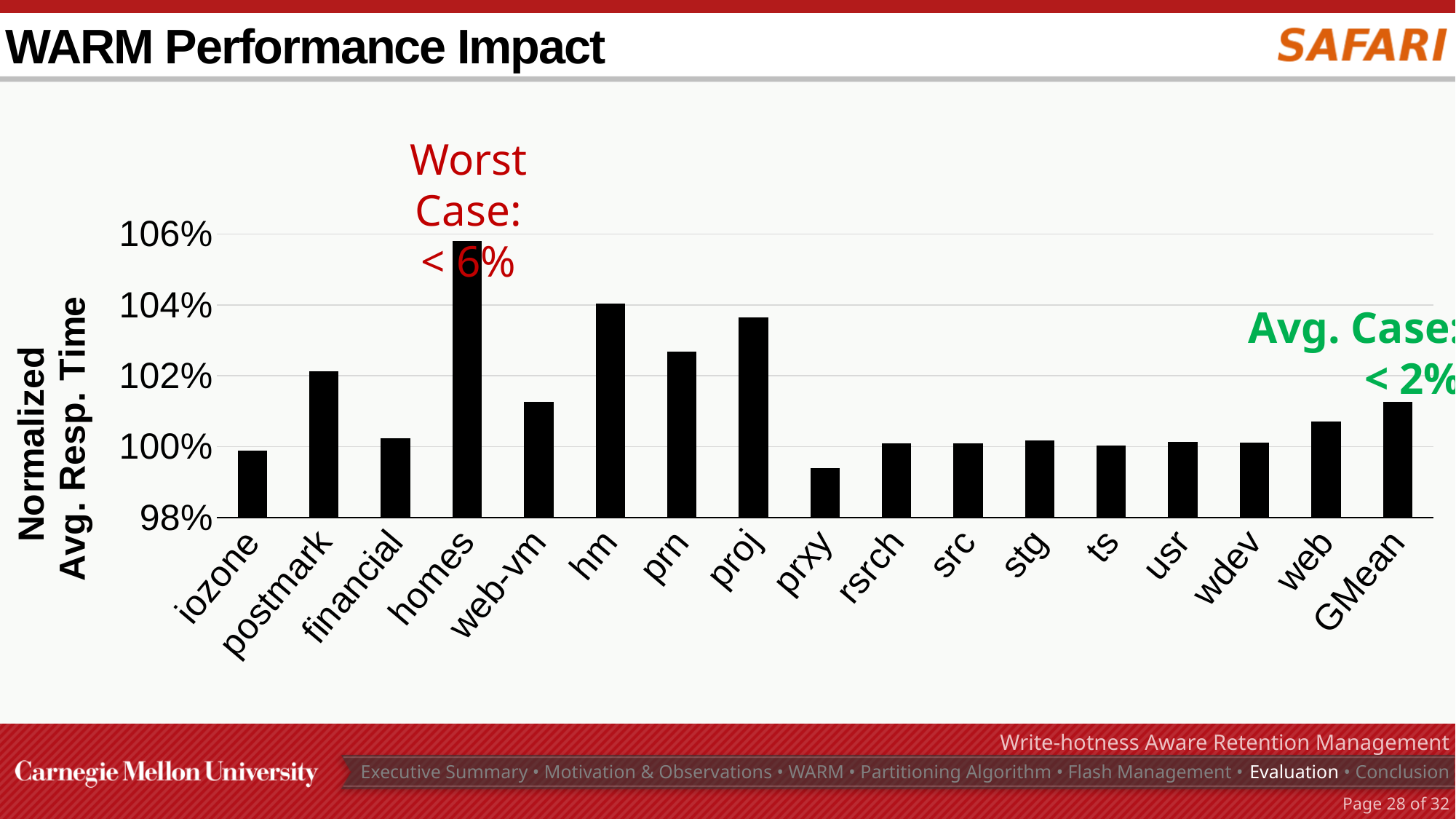
Which category has the lowest normalized average response time? prxy What is the label on the vertical axis of the chart? Normalized Avg. Resp. Time What does the red annotation above the homes bar say? Worst Case: < 6% Is the value for homes greater or less than 104%? greater Is the value for proj greater or less than 102%? greater What kind of chart is shown on the slide? bar chart How many bars (categories) are plotted in the chart? 17 Is the value for prxy greater or less than 100%? less Which category has the highest normalized average response time? homes Which is larger, the value for homes or the value for hm? homes Which is larger, the value for proj or the value for prn? proj